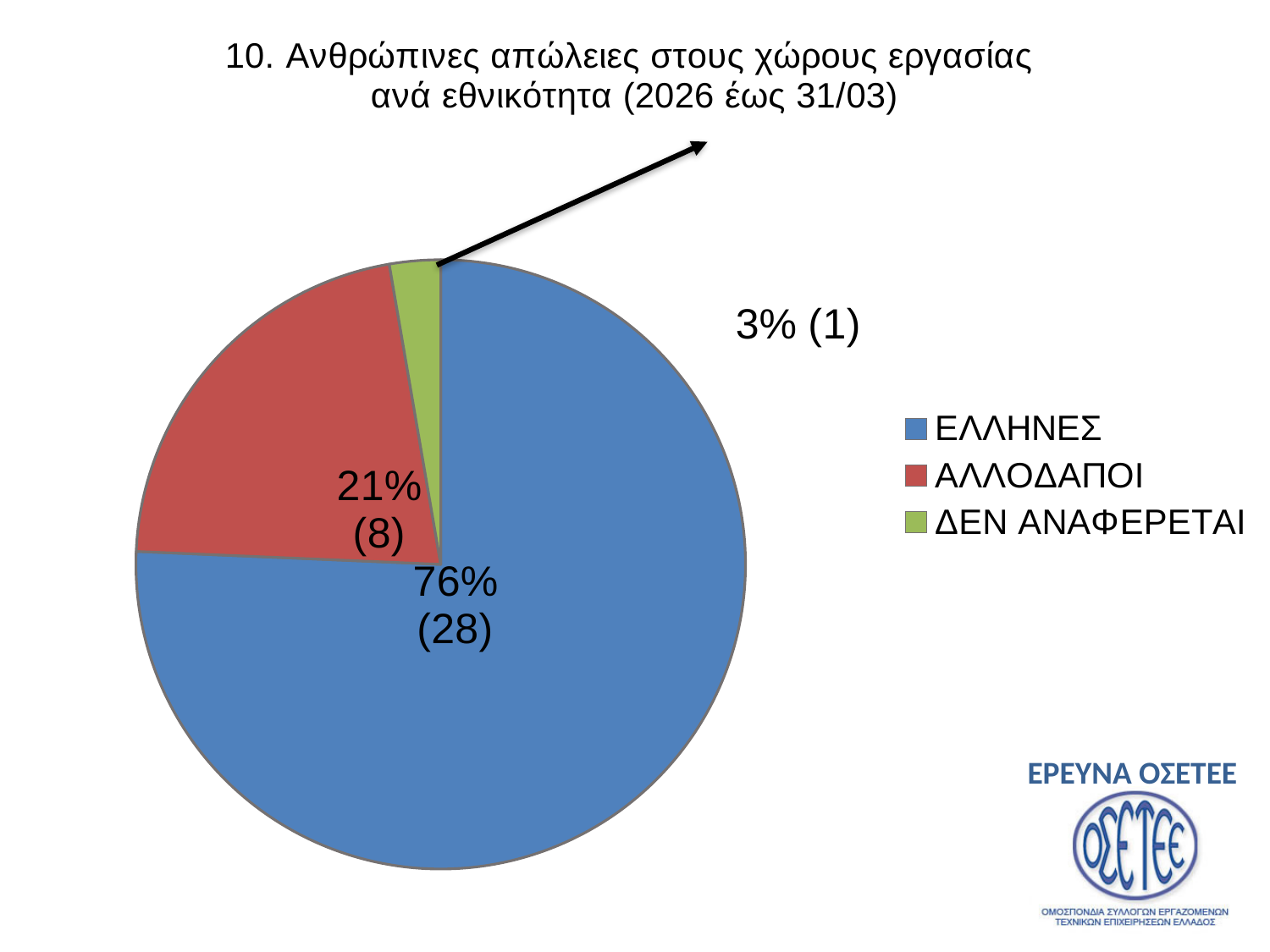
What is the difference in cases between ΕΛΛΗΝΕΣ and ΑΛΛΟΔΑΠΟΙ? 20 What percentage of the pie does ΕΛΛΗΝΕΣ represent? 76% What percentage of the pie does ΔΕΝ ΑΝΑΦΕΡΕΤΑΙ represent? 3% What percentage of the pie does ΑΛΛΟΔΑΠΟΙ represent? 21% Which category has the largest slice of the pie? ΕΛΛΗΝΕΣ How many cases are shown for ΔΕΝ ΑΝΑΦΕΡΕΤΑΙ? 1 How many categories does the pie chart have? 3 How many cases are shown for ΕΛΛΗΝΕΣ? 28 What kind of chart is shown on the slide? pie chart What colour is the slice for ΑΛΛΟΔΑΠΟΙ? red Which category has the smallest slice of the pie? ΔΕΝ ΑΝΑΦΕΡΕΤΑΙ How many cases are shown for ΑΛΛΟΔΑΠΟΙ? 8